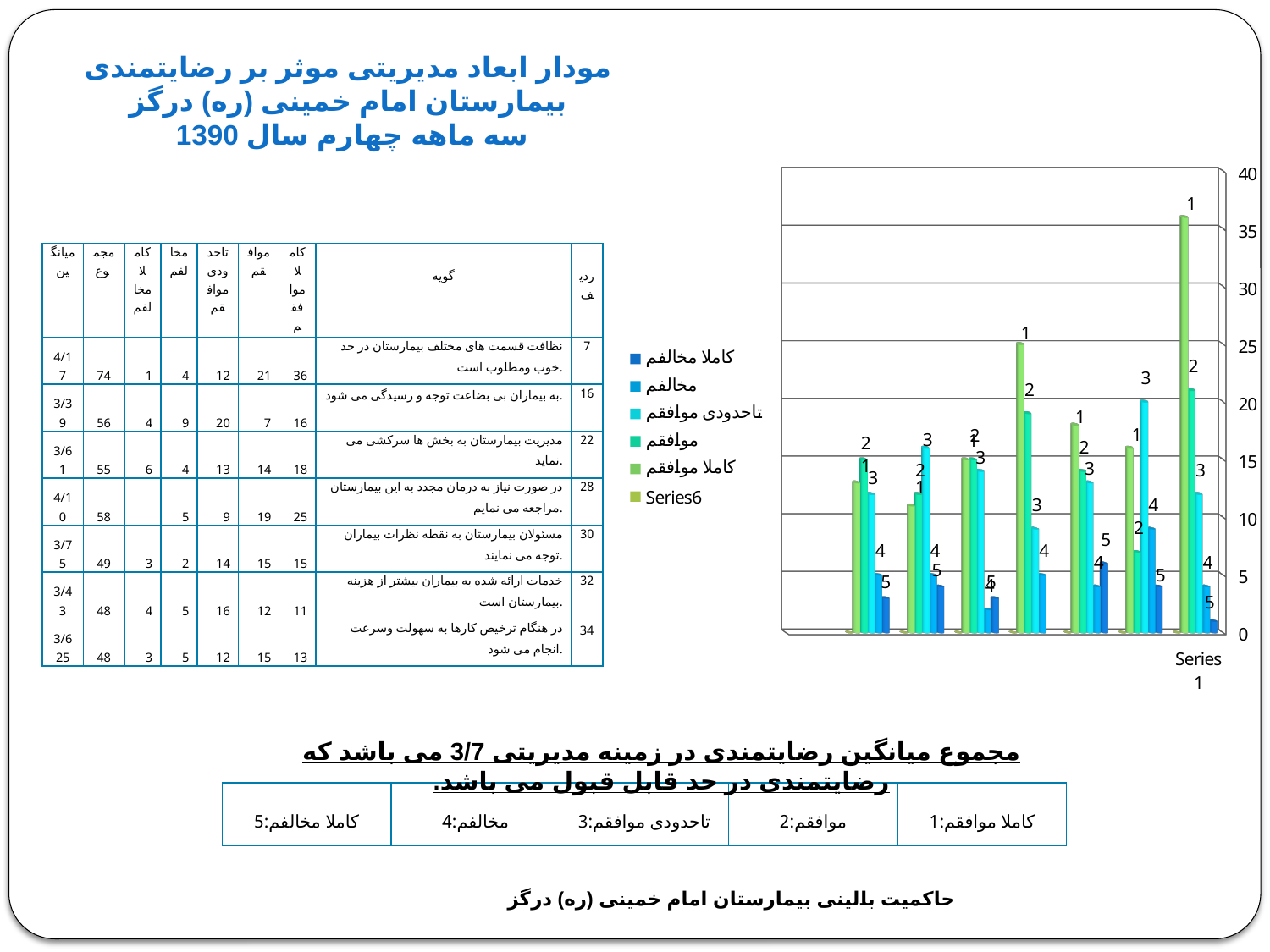
Is the tallest bar in the chart greater or less than 30? greater In the leftmost group of bars, is the value for کاملا مخالفم greater or less than 5? less What is the title of the chart on the slide? مودار ابعاد مدیریتی موثر بر رضایتمندی بیمارستان امام خمینی (ره) درگز سه ماهه چهارم سال 1390 In the rightmost group of bars, is the value for موافقم greater or less than 15? greater Which series does the tallest bar in the chart belong to? کاملا موافقم In the rightmost group of bars, which is larger: the bar for کاملا موافقم or the bar for مخالفم? کاملا موافقم What is the last entry listed in the chart legend? Series6 How many groups of bars are plotted in the chart? 7 What kind of chart is shown on the slide? bar chart How many series does the chart legend list? 6